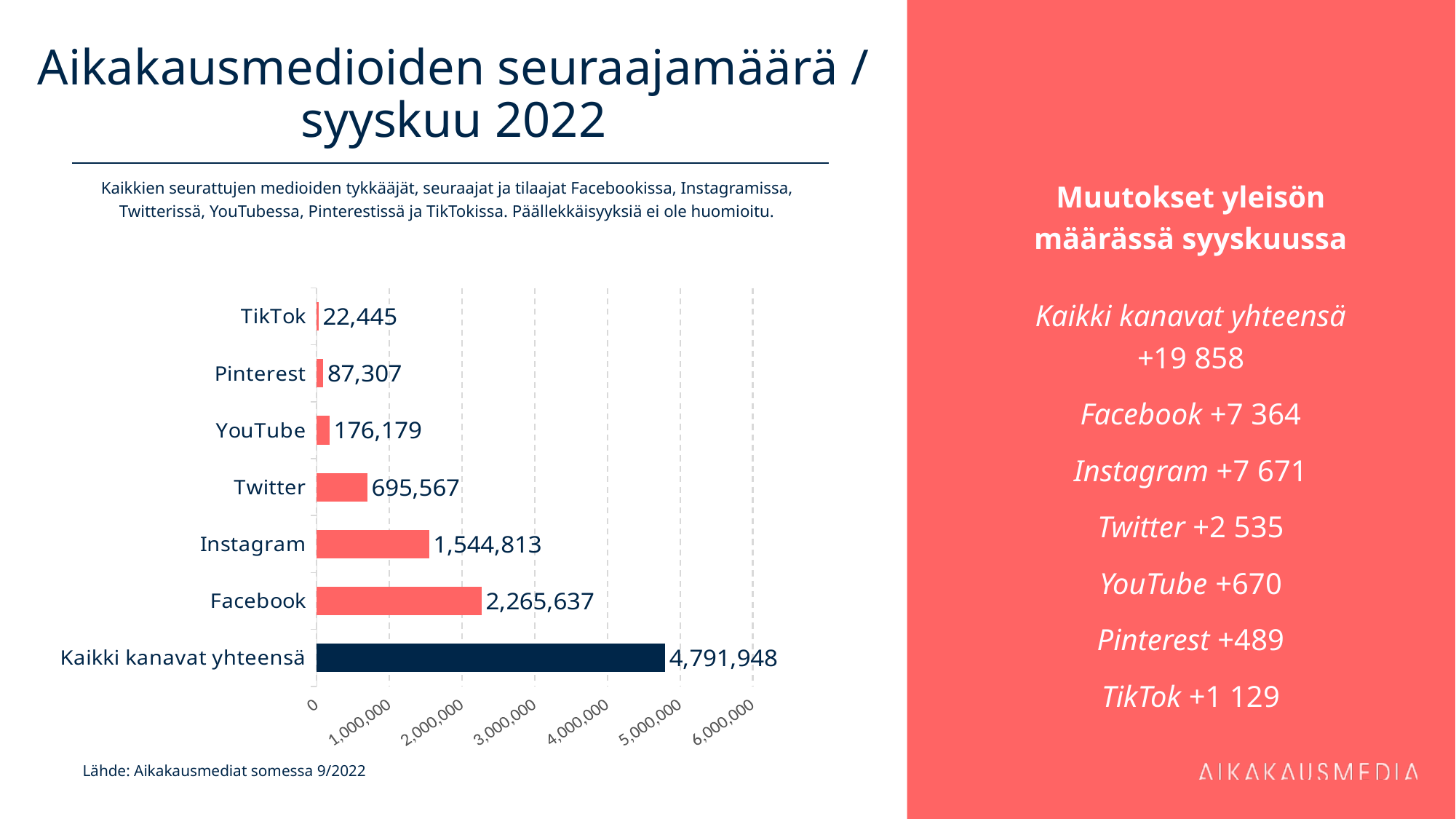
What is the value for TikTok? 22,445 What is the value for Facebook? 2,265,637 What is the difference between the values for Twitter and YouTube? 519,388 How many categories are shown in the chart? 7 What is the difference between the values for Facebook and Instagram? 720,824 What is the value for Instagram? 1,544,813 Which category has the highest value? Kaikki kanavat yhteensä What kind of chart is shown on the slide? Bar chart What is the value for Kaikki kanavat yhteensä? 4,791,948 Is the value for Facebook greater or less than 2,000,000? greater Which is larger, the value for Instagram or the value for Twitter? Instagram Which category has the lowest value? TikTok